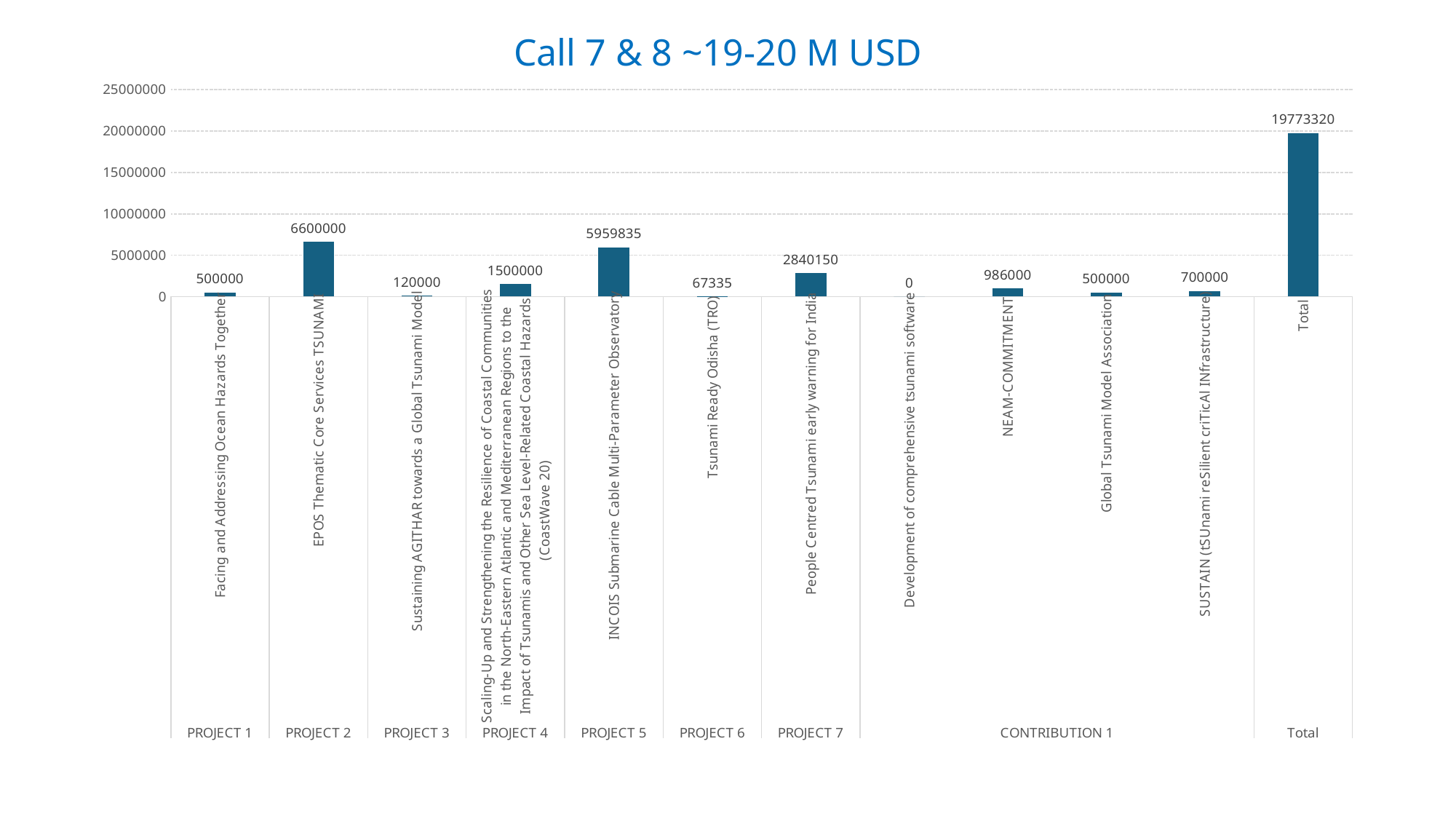
What is the title of the chart? Call 7 & 8 ~19-20 M USD Which category has the lowest value? Development of comprehensive tsunami software What is the value for INCOIS Submarine Cable Multi-Parameter Observatory? 5959835 What is the difference between the values for EPOS Thematic Core Services TSUNAMI and INCOIS Submarine Cable Multi-Parameter Observatory? 640165 Which is larger, the value for People Centred Tsunami early warning for India or the value for CoastWave 20? People Centred Tsunami early warning for India What is the value for NEAM-COMMITMENT? 986000 What is the value for Tsunami Ready Odisha (TRO)? 67335 Is the value for the Total bar greater or less than 15000000? greater What is the value shown for the Total bar? 19773320 What is the value for EPOS Thematic Core Services TSUNAMI? 6600000 What kind of chart is shown on the slide? Bar chart Excluding the Total bar, which category has the highest value? EPOS Thematic Core Services TSUNAMI